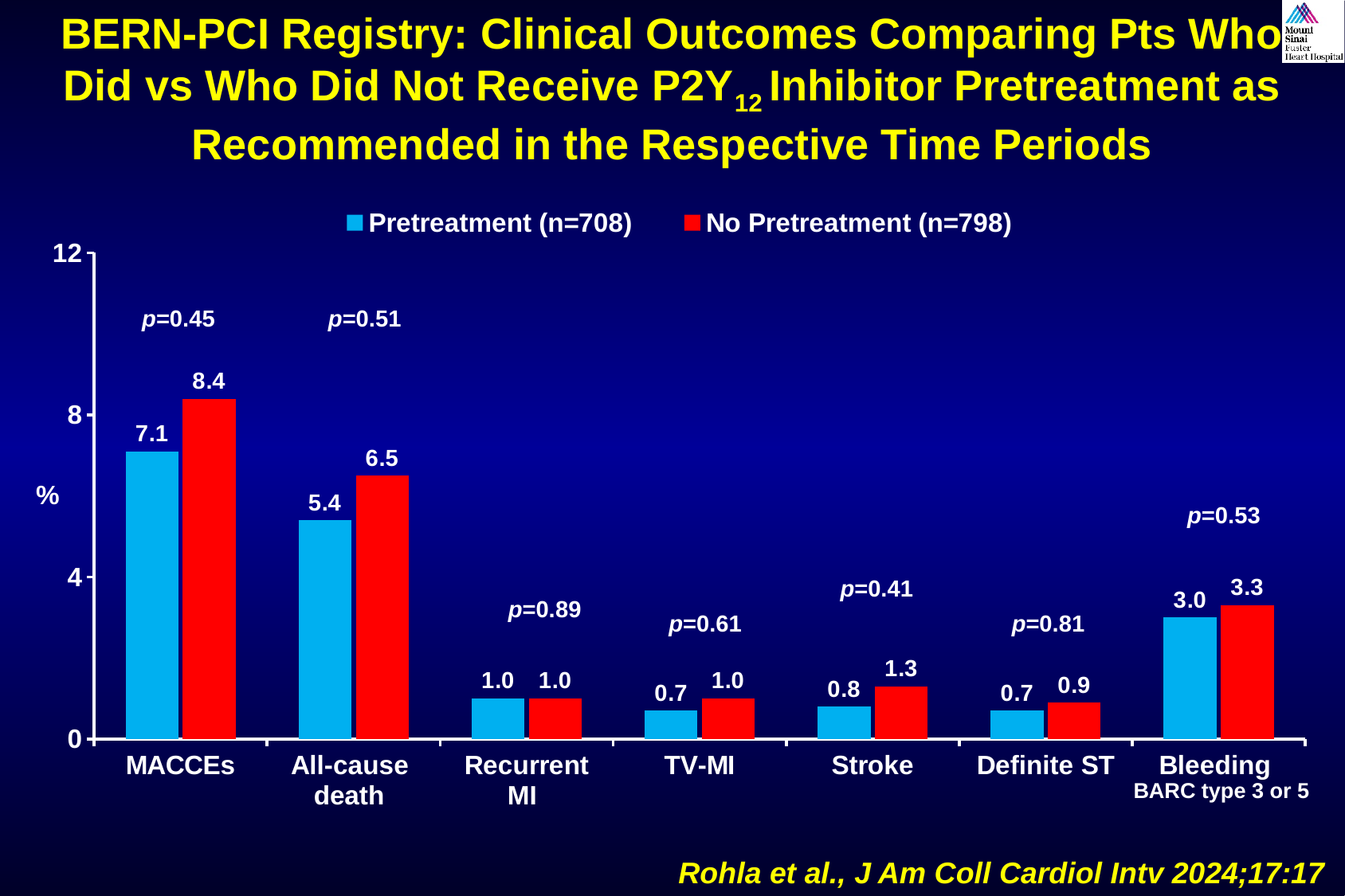
How many outcome categories are shown on the x axis? 7 Which outcome category has the lowest value for the No Pretreatment (n=798) group? Definite ST What is the Stroke value for the No Pretreatment (n=798) group? 1.3 What is the All-cause death value for the Pretreatment (n=708) group? 5.4 What is the difference between the No Pretreatment and Pretreatment values for MACCEs? 1.3 What p-value is shown for the Recurrent MI comparison? p=0.89 What kind of chart is shown on the slide? Bar chart What is the difference between the No Pretreatment and Pretreatment values for All-cause death? 1.1 Which outcome category has the highest value for the Pretreatment (n=708) group? MACCEs For Bleeding BARC type 3 or 5, which group has the larger value, Pretreatment or No Pretreatment? No Pretreatment What is the MACCEs value for the No Pretreatment (n=798) group? 8.4 How many series does the legend list? 2